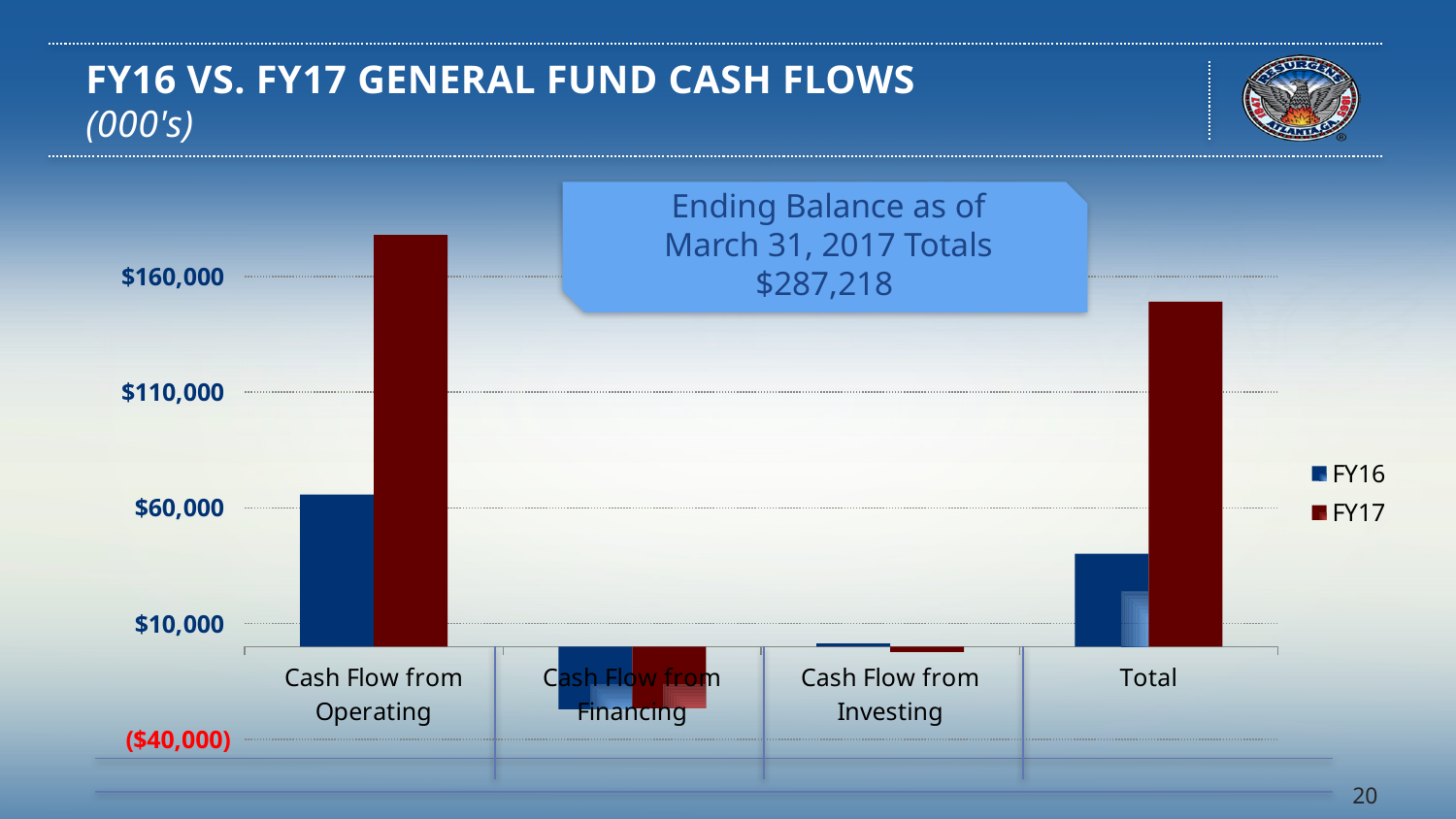
Which category has the highest FY17 value? Cash Flow from Operating Which category has the lowest FY17 value? Cash Flow from Financing Is the FY17 value for Cash Flow from Financing greater or less than $10,000? less Is the FY16 value for Total greater or less than $60,000? less How many series does the chart's legend list? 2 How many categories are shown on the x axis of the chart? 4 For Total, which is larger, the FY16 value or the FY17 value? FY17 For Cash Flow from Operating, which is larger, the FY16 value or the FY17 value? FY17 Is the FY17 value for Cash Flow from Operating greater or less than $160,000? greater What kind of chart is shown on the slide? bar chart What ending balance total as of March 31, 2017 is shown in the callout on the chart? $287,218